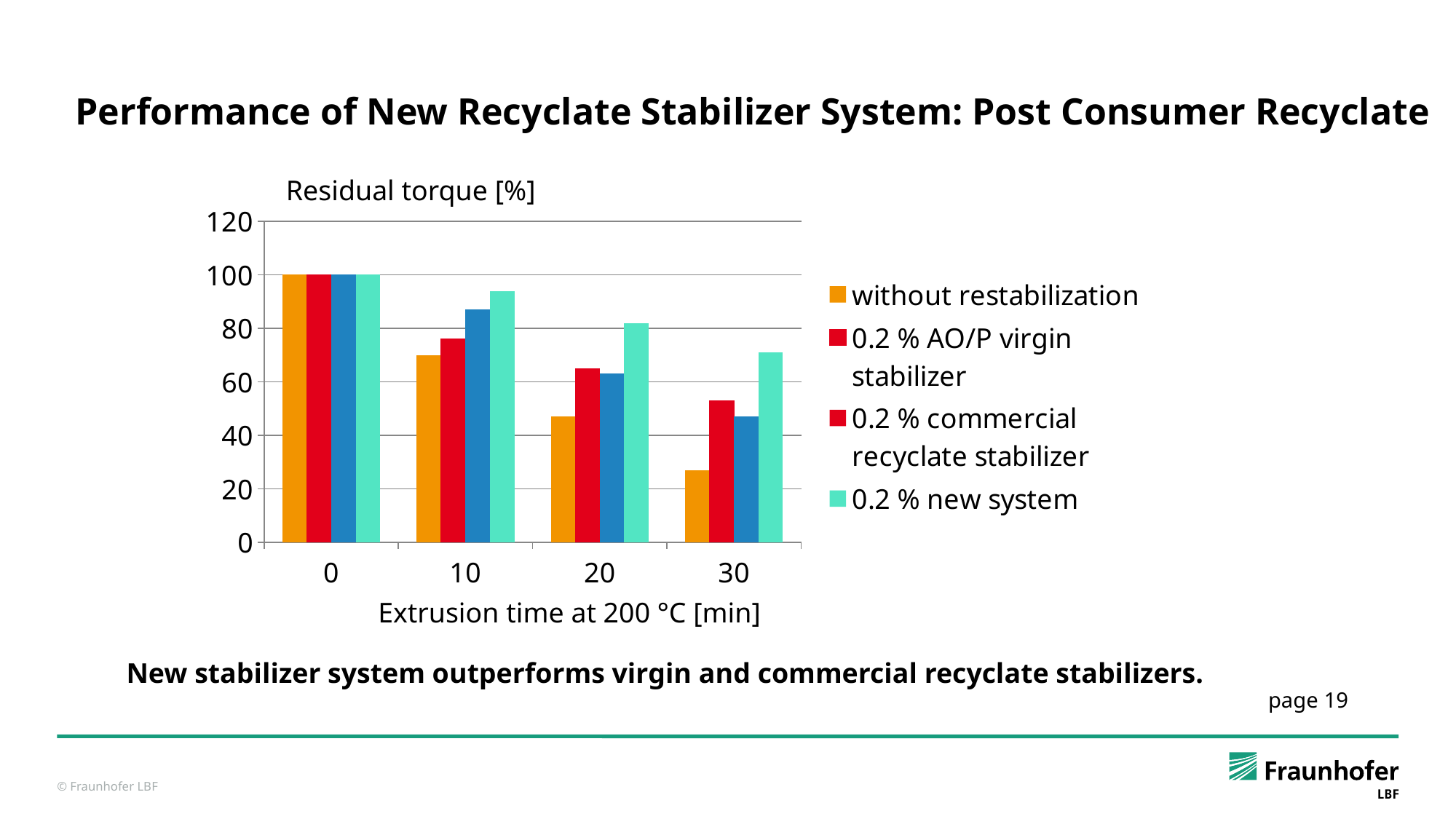
Does the residual torque for 'without restabilization' rise or fall as extrusion time increases? fall Is the value for '0.2 % new system' at 10 min greater or less than 80? greater What is the residual torque for 'without restabilization' at 0 min? 100 Which series has the highest residual torque at 30 min? 0.2 % new system What kind of chart is shown on the slide? bar chart Is the value for '0.2 % new system' at 30 min greater or less than 60? greater What is the residual torque for '0.2 % new system' at 0 min? 100 How many extrusion time categories are shown on the x axis? 4 At 10 min, which is larger: '0.2 % AO/P virgin stabilizer' or '0.2 % commercial recyclate stabilizer'? 0.2 % commercial recyclate stabilizer Which series has the lowest residual torque at 30 min? without restabilization Is the value for 'without restabilization' at 30 min greater or less than 40? less How many series does the legend list? 4